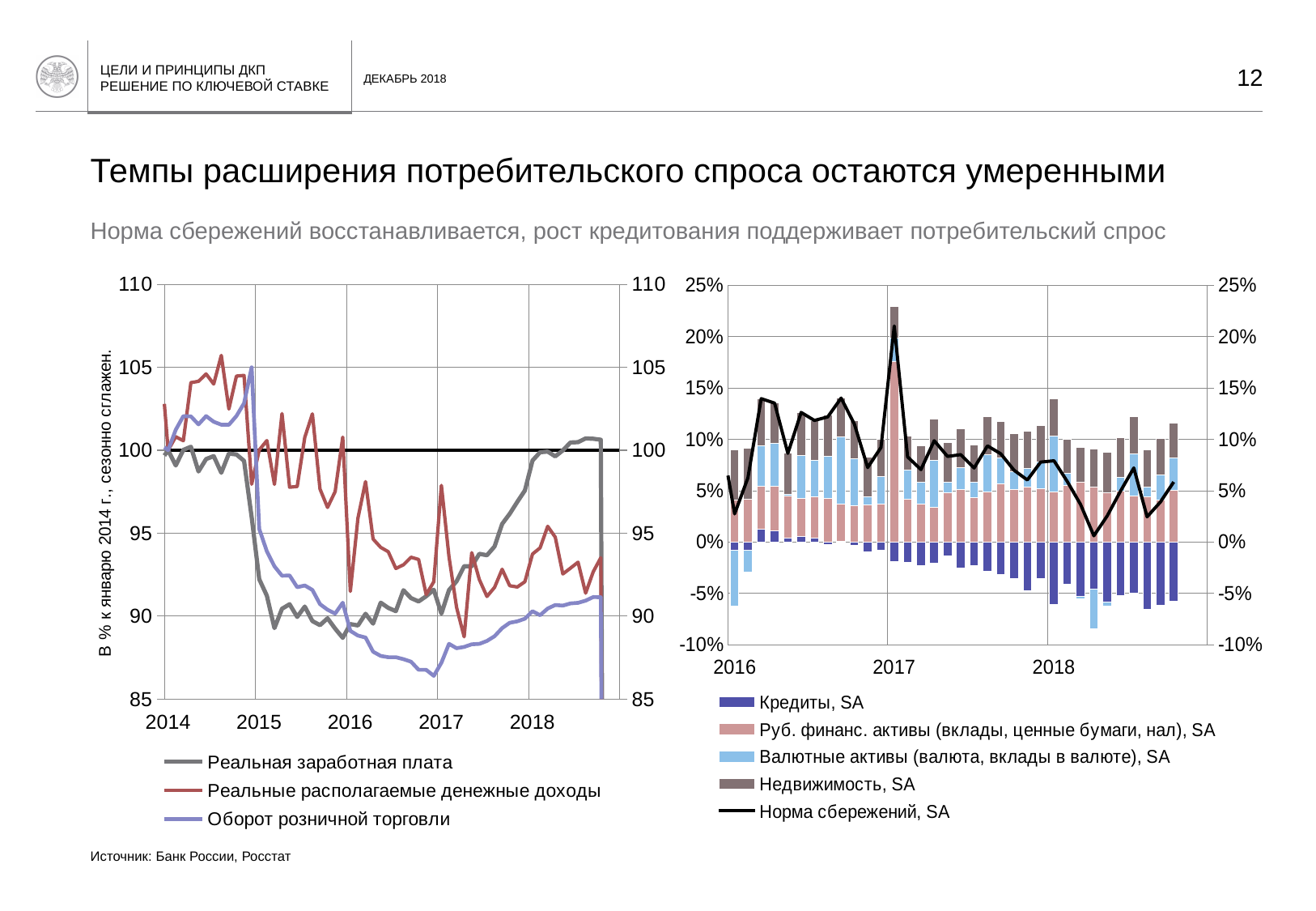
In the left chart, does Оборот розничной торговли rise or fall between 2015 and 2017? fall In the right chart, which series is drawn as a line rather than bars? Норма сбережений, SA In the left chart, does Реальная заработная плата rise or fall between 2017 and 2018? rise In the right chart, is the peak value of Норма сбережений, SA at the start of 2017 greater or less than 15%? greater How many series does the legend of the left chart list? 3 How many series does the legend of the right chart list? 5 In the right chart, does Норма сбережений, SA rise or fall between the start of 2017 and the start of 2018? fall What kind of chart is the left chart (В % к январю 2014 г., сезонно сглажен.)? line chart What kind of chart is the right chart (with Норма сбережений, SA)? combination bar and line chart (stacked bars with a line) In the left chart, is the value for Реальная заработная плата at the start of 2016 greater or less than 95? less In the left chart, is the value for Оборот розничной торговли at the start of 2017 greater or less than 90? less